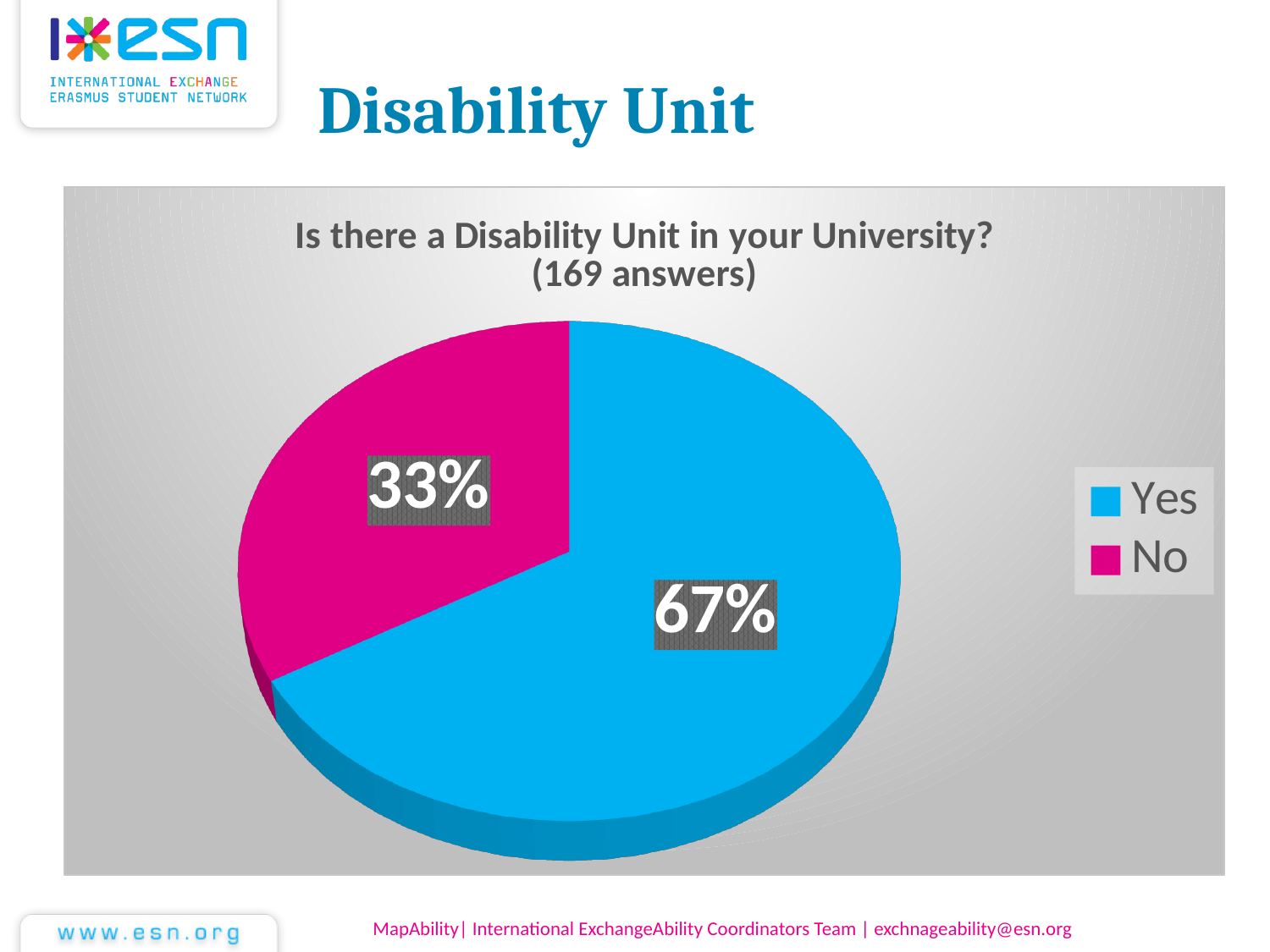
Which category has the smallest slice of the pie? No What is the difference in percentage points between the "Yes" and "No" slices? 34 What kind of chart is shown on the slide? Pie chart How many answers does the chart title say the survey received? 169 What share of the pie does the "No" slice represent? 33% What is the title of the chart? Is there a Disability Unit in your University? (169 answers) Which is larger, the "Yes" slice or the "No" slice? Yes How many entries does the legend list? 2 How many categories does the pie chart show? 2 Which category has the largest slice of the pie? Yes What share of the pie does the "Yes" slice represent? 67% What colour is the "No" slice in the pie chart? Magenta (pink)